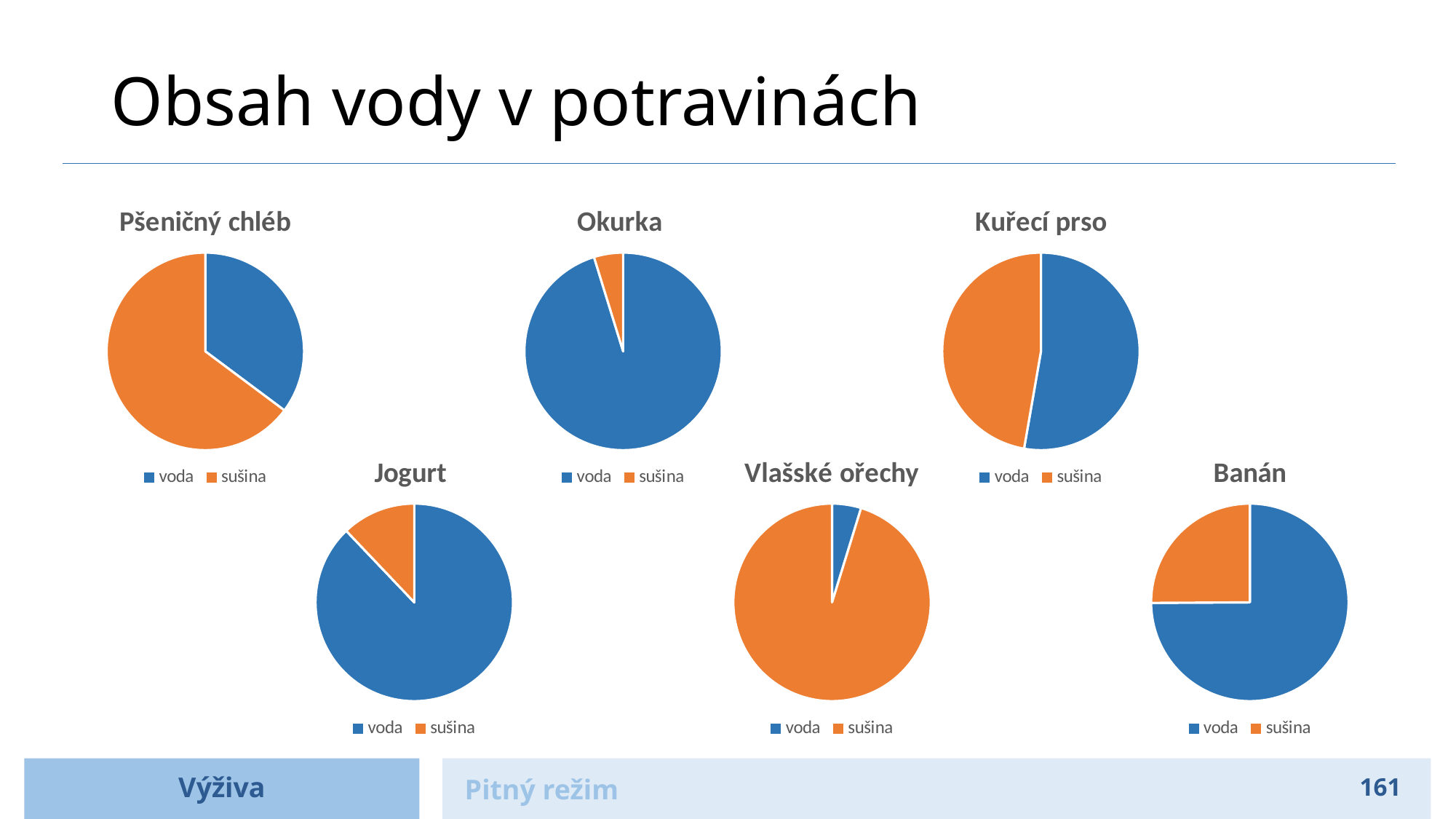
How many slices does the "Pšeničný chléb" pie chart have? 2 What kind of chart is used for "Okurka"? pie chart Across the six pie charts, which food has the smallest voda slice? Vlašské ořechy In the "Pšeničný chléb" chart, which slice is larger, voda or sušina? sušina Across the six pie charts, which food has the largest voda slice? Okurka In the "Jogurt" chart, which slice is larger, voda or sušina? voda In the "Banán" chart, which slice is larger, voda or sušina? voda How many pie charts are shown on the slide? 6 How many series does the legend of the "Banán" chart list? 2 What colour represents "sušina" in the pie charts? orange